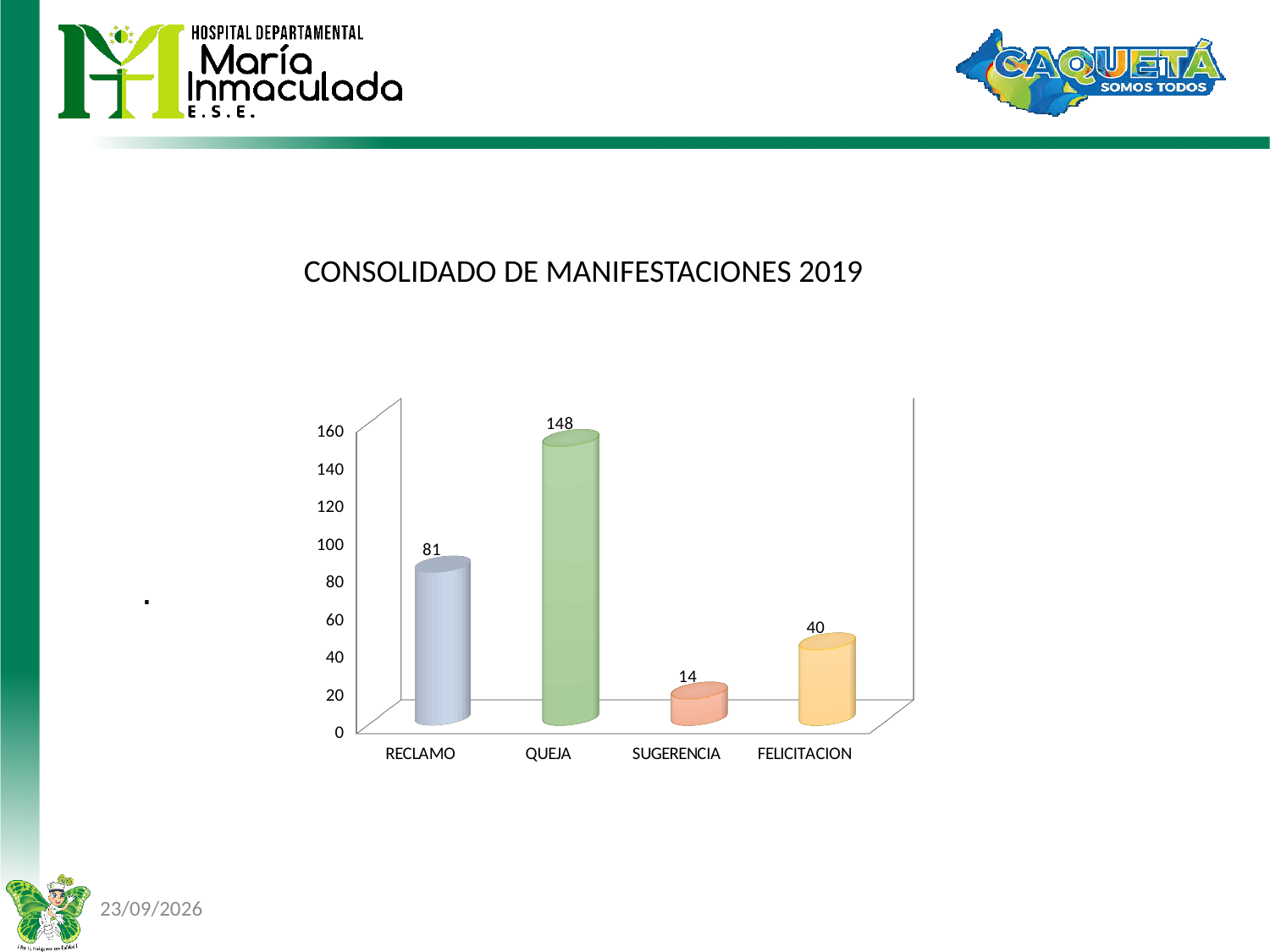
Which category has the highest value? QUEJA Which is larger, the value for FELICITACION or the value for SUGERENCIA? FELICITACION Which category has the lowest value? SUGERENCIA What kind of chart is shown on the slide? bar chart What is the value for FELICITACION? 40 Is the value for RECLAMO greater or less than 100? less What is the title of the chart? CONSOLIDADO DE MANIFESTACIONES 2019 What is the value for QUEJA? 148 What is the difference between the values for QUEJA and RECLAMO? 67 How many categories are shown on the x axis? 4 What is the value for RECLAMO? 81 What is the value for SUGERENCIA? 14